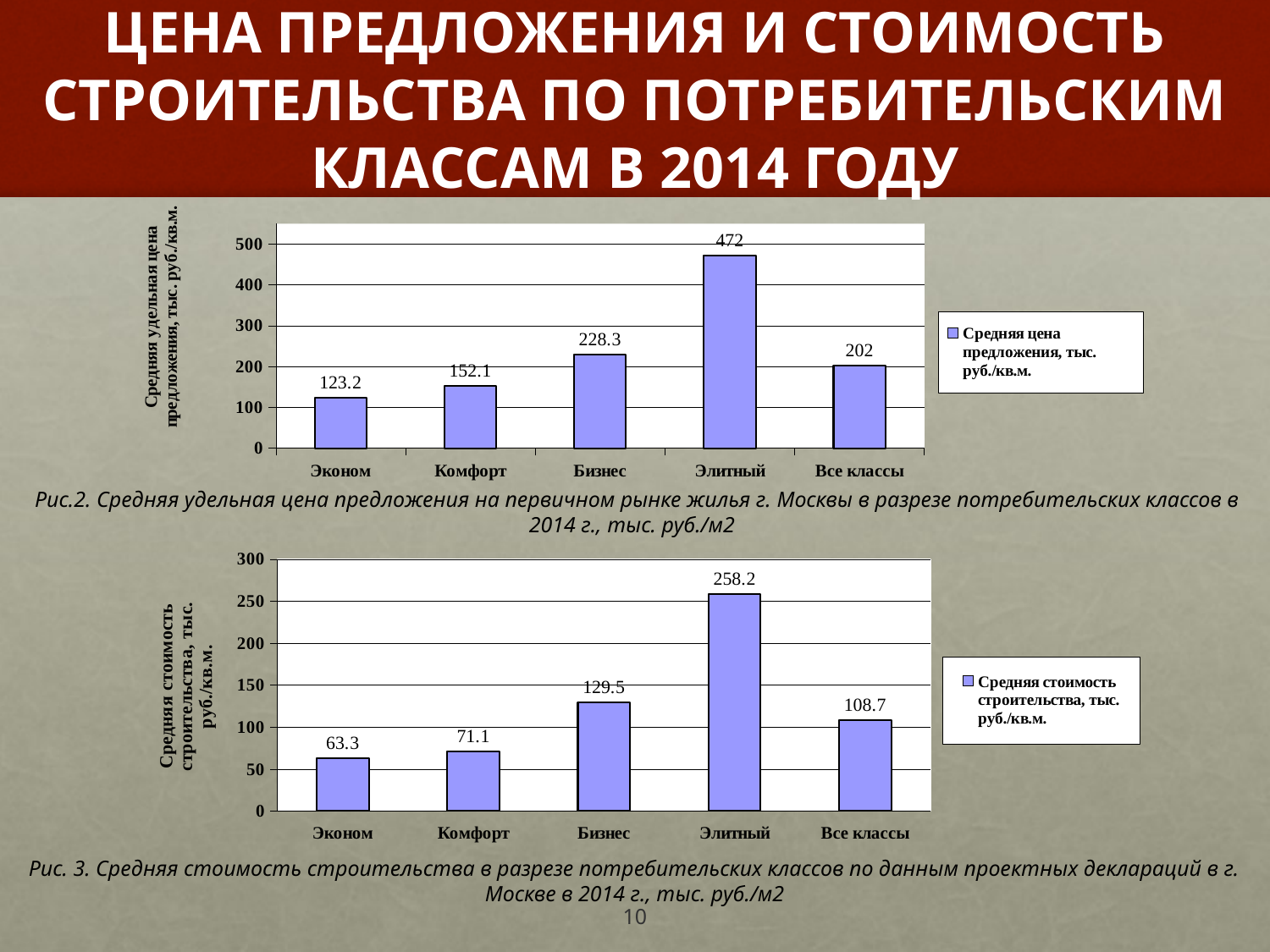
In the bottom chart (Рис. 3), which category has the highest value? Элитный In the top chart (Рис.2), what is the average offer price for Бизнес? 228.3 In the bottom chart (Рис. 3), what is the value for Все классы? 108.7 What kind of chart is the bottom chart (Рис. 3)? Bar chart In the top chart (Рис.2), how many categories are shown on the x axis? 5 How many series does the legend of the top chart (Рис.2) list? 1 In the bottom chart (Рис. 3), what is the average construction cost for Комфорт? 71.1 In the top chart (Рис.2), which category has the highest value? Элитный In the bottom chart (Рис. 3), what is the difference between the values for Бизнес and Эконом? 66.2 In the bottom chart (Рис. 3), which is larger, the value for Бизнес or the value for Все классы? Бизнес In the top chart (Рис.2), which category has the lowest value? Эконом In the top chart (Рис.2), what is the difference between the values for Элитный and Эконом? 348.8